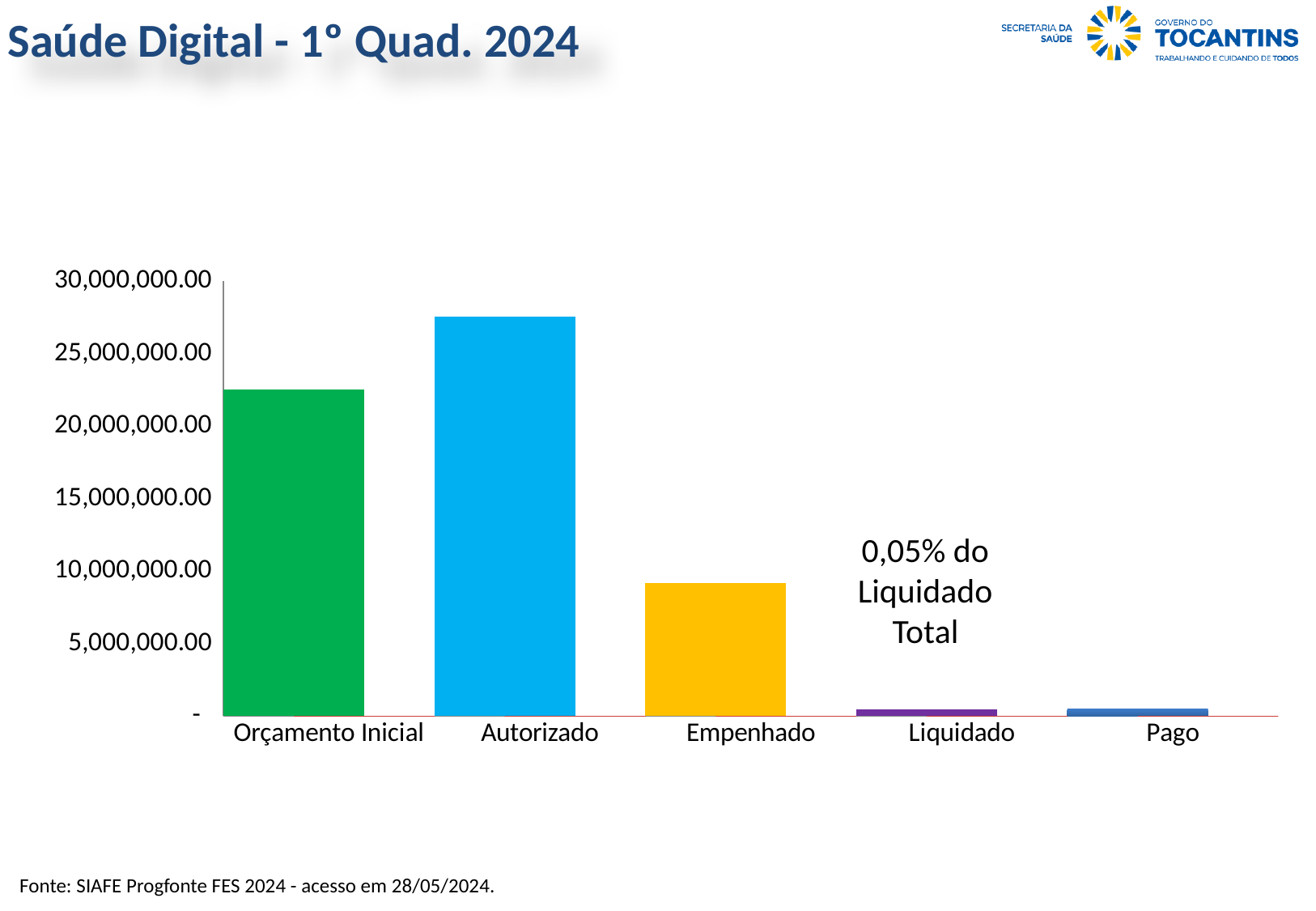
What kind of chart is shown on the slide? bar chart How many categories are shown on the x axis of the chart? 5 Which is larger, the value for Orçamento Inicial or the value for Autorizado? Autorizado Is the value for Liquidado greater or less than 5,000,000.00? less Which is larger, the value for Empenhado or the value for Orçamento Inicial? Orçamento Inicial Which category has the highest value in the chart? Autorizado What is the title of the slide containing the chart? Saúde Digital - 1° Quad. 2024 Is the value for Autorizado greater or less than 25,000,000.00? greater Is the value for Empenhado greater or less than 10,000,000.00? less What annotation text is written above the Liquidado bar? 0,05% do Liquidado Total